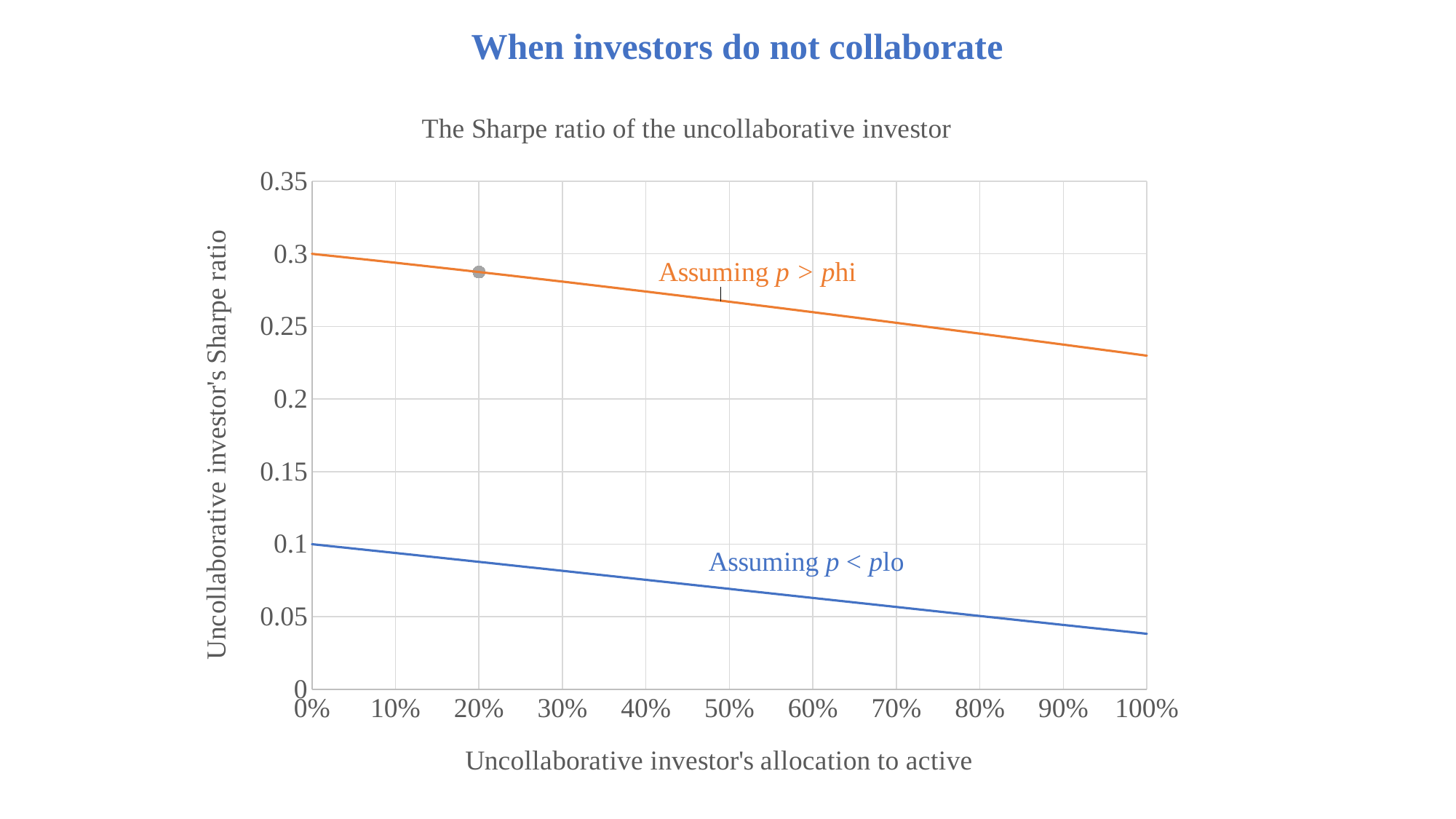
Which line has the higher Sharpe ratio at an allocation of 50%, 'Assuming p > phi' or 'Assuming p < plo'? Assuming p > phi What is the title of the chart? The Sharpe ratio of the uncollaborative investor Does the 'Assuming p > phi' line rise or fall as the allocation to active increases? fall Does the 'Assuming p < plo' line rise or fall as the allocation to active increases? fall What is the Sharpe ratio of the 'Assuming p > phi' line at an allocation of 0%? 0.3 Is the value of the 'Assuming p < plo' line at 100% allocation greater or less than 0.05? less What is the label of the x axis? Uncollaborative investor's allocation to active What is the Sharpe ratio of the 'Assuming p < plo' line at an allocation of 0%? 0.1 How many lines are plotted on the chart? 2 What kind of chart is shown on the slide? line chart Is the value of the 'Assuming p > phi' line at 50% allocation greater or less than 0.25? greater Is the value of the 'Assuming p > phi' line at 100% allocation greater or less than 0.2? greater